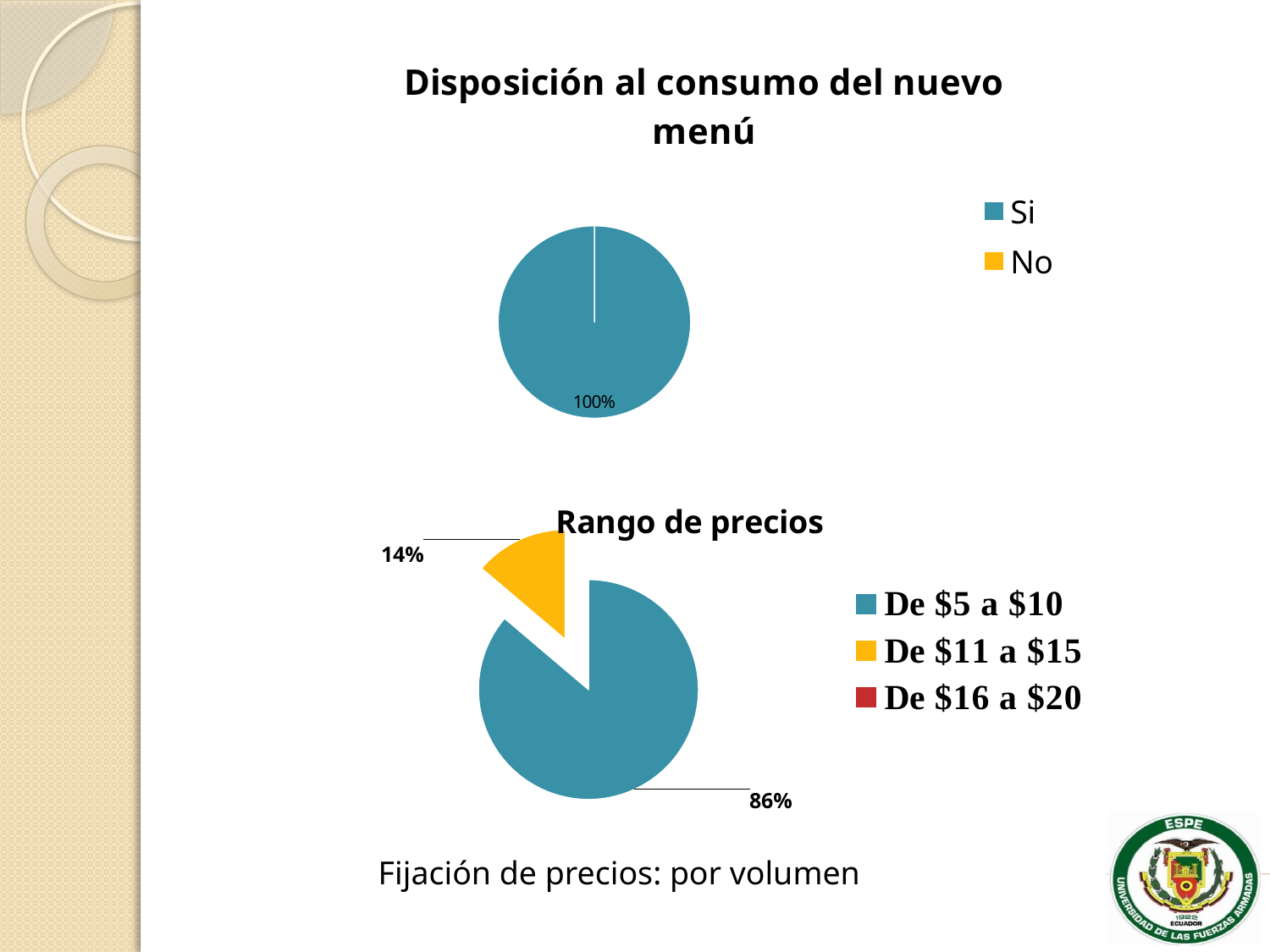
In the 'Rango de precios' chart, what share is labelled for De $5 a $10? 86% In the 'Disposición al consumo del nuevo menú' chart, what share is labelled for Si? 100% What is the title of the top chart on the slide? Disposición al consumo del nuevo menú In the 'Rango de precios' chart, which is larger: De $5 a $10 or De $11 a $15? De $5 a $10 In the 'Rango de precios' chart, what share is labelled for De $11 a $15? 14% In the 'Rango de precios' chart, what colour is the De $11 a $15 slice? yellow What kind of chart is 'Rango de precios'? pie chart In the 'Rango de precios' chart, what is the difference between the De $5 a $10 share and the De $11 a $15 share? 72% How many entries does the legend of the 'Rango de precios' chart list? 3 In the 'Rango de precios' chart, which category has the largest slice? De $5 a $10 How many entries does the legend of the 'Disposición al consumo del nuevo menú' chart list? 2 What kind of chart is 'Disposición al consumo del nuevo menú'? pie chart